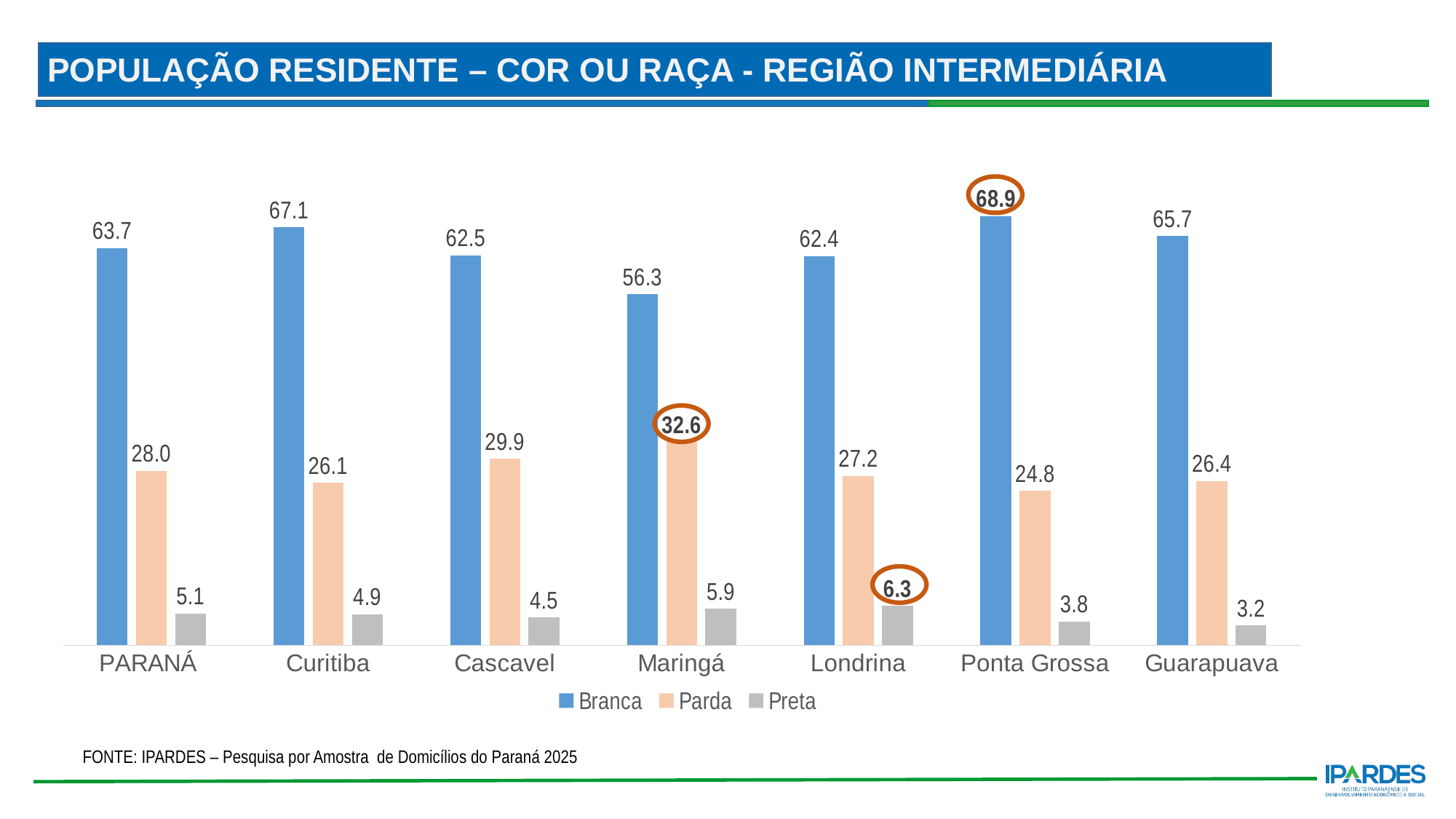
Which series is shown in blue? Branca What is the Branca value for PARANÁ? 63.7 What is the Preta value for Londrina? 6.3 Which is larger, the Parda value for Cascavel or the Parda value for Londrina? Cascavel How many categories are shown on the x axis? 7 Which category has the lowest Preta value? Guarapuava What is the Branca value for Ponta Grossa? 68.9 Which category has the highest Branca value? Ponta Grossa What is the Parda value for Maringá? 32.6 What is the difference between the Branca values for Curitiba and Maringá? 10.8 What kind of chart is shown on the slide? bar chart How many series does the legend list? 3